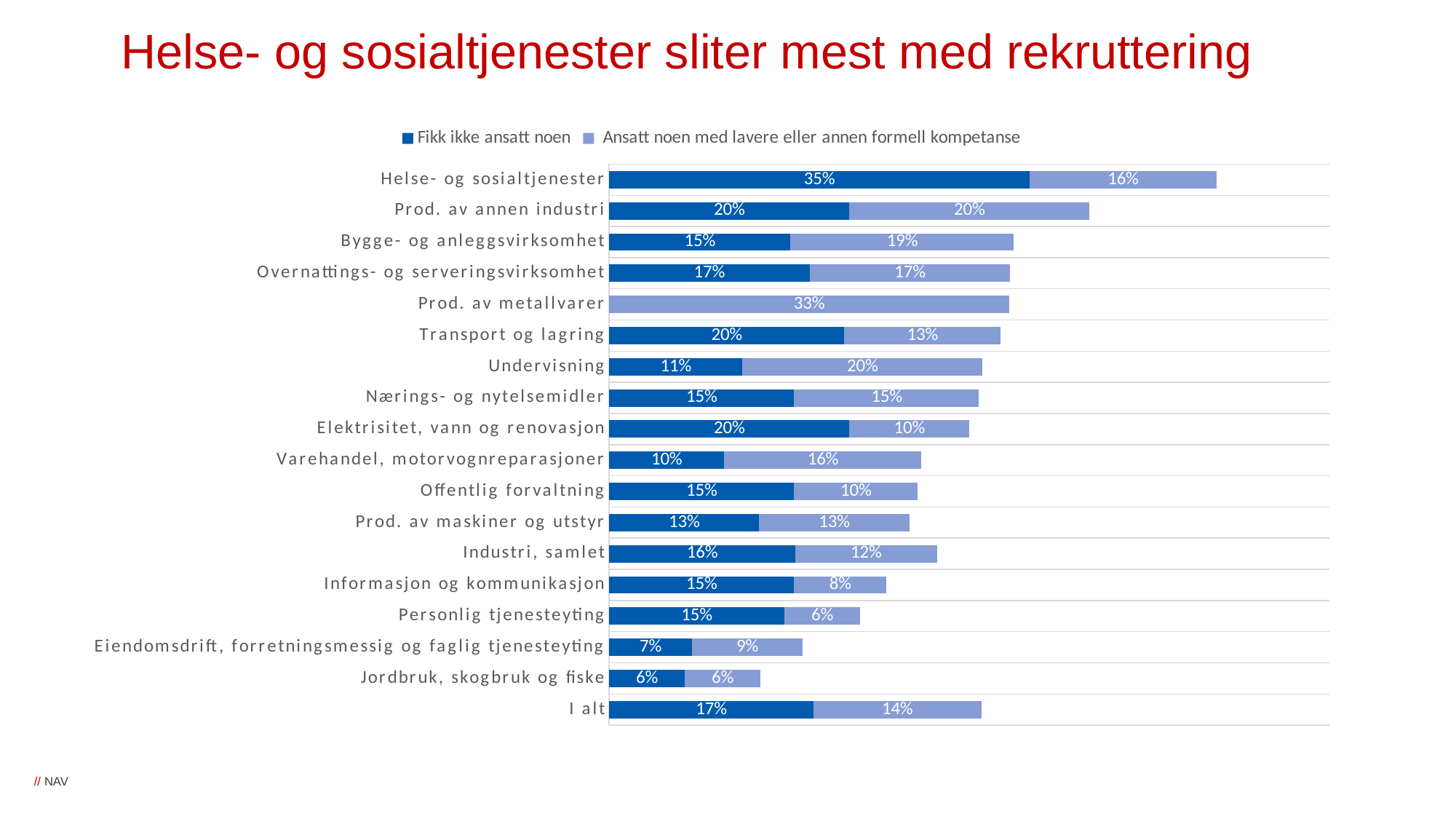
How many series does the legend list? 2 Which category has the highest value for 'Fikk ikke ansatt noen'? Helse- og sosialtjenester What is the total of the stacked bar for Helse- og sosialtjenester? 51% What kind of chart is shown on the slide? Stacked bar chart Which has the larger 'Fikk ikke ansatt noen' value, Transport og lagring or Undervisning? Transport og lagring How many categories are plotted on the chart? 18 What is the value of 'Ansatt noen med lavere eller annen formell kompetanse' for Prod. av metallvarer? 33% What is the value of 'Fikk ikke ansatt noen' for I alt? 17% What is the value of 'Fikk ikke ansatt noen' for Helse- og sosialtjenester? 35% Which category has the highest value for 'Ansatt noen med lavere eller annen formell kompetanse'? Prod. av metallvarer What is the difference between the 'Fikk ikke ansatt noen' values for Helse- og sosialtjenester and Undervisning? 24 percentage points Which category has the lowest value for 'Fikk ikke ansatt noen'? Prod. av metallvarer